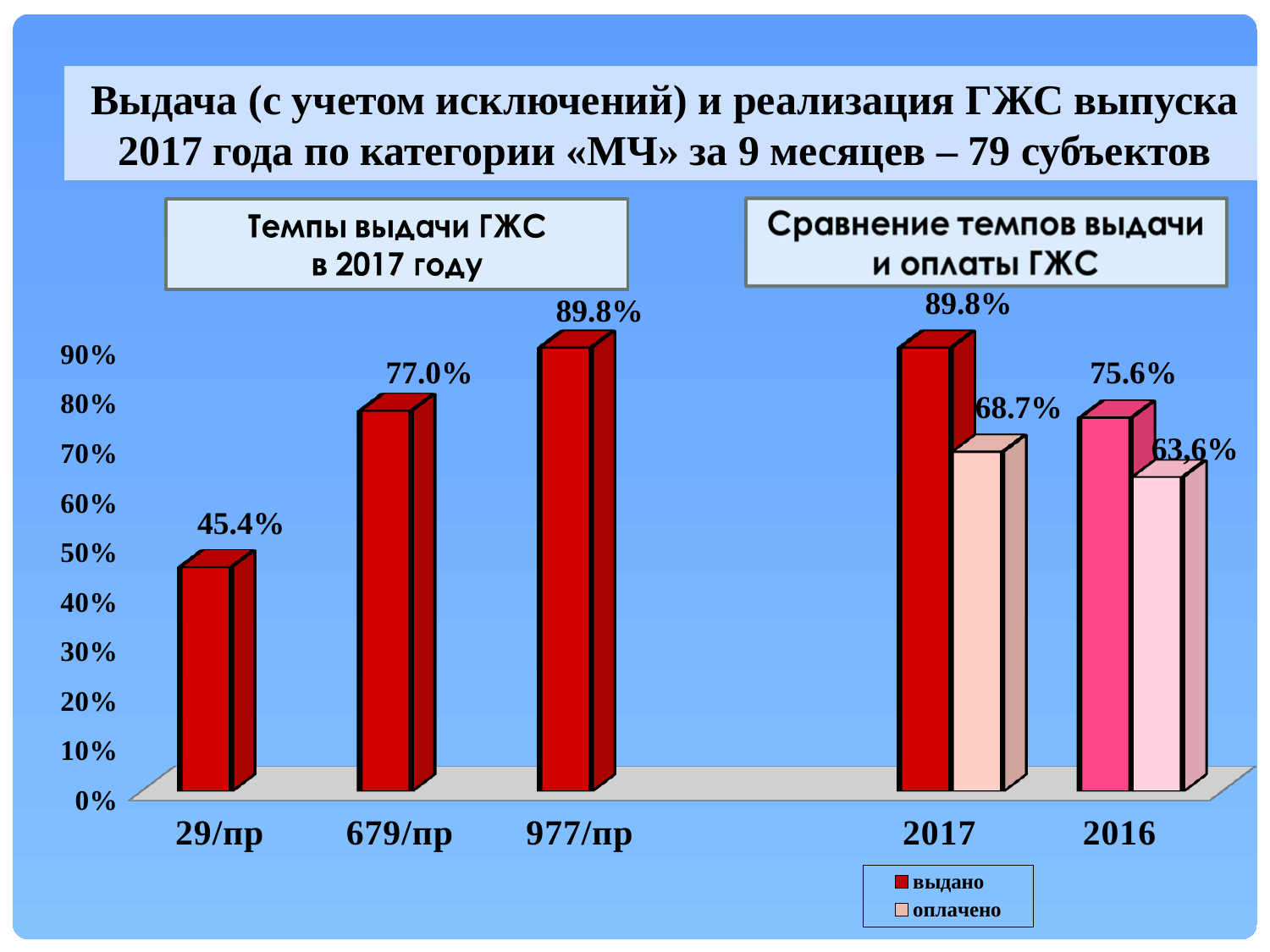
In the chart 'Сравнение темпов выдачи и оплаты ГЖС', how many series does the legend list? 2 In the chart 'Темпы выдачи ГЖС в 2017 году', which category has the highest value? 977/пр In the chart 'Темпы выдачи ГЖС в 2017 году', what is the value for 679/пр? 77.0% In the chart 'Темпы выдачи ГЖС в 2017 году', do the values rise or fall from left to right? rise In the chart 'Сравнение темпов выдачи и оплаты ГЖС', what is the 'выдано' value for 2016? 75.6% In the chart 'Темпы выдачи ГЖС в 2017 году', what is the value for 29/пр? 45.4% In the chart 'Сравнение темпов выдачи и оплаты ГЖС', what is the 'оплачено' value for 2017? 68.7% In the chart 'Темпы выдачи ГЖС в 2017 году', which category has the lowest value? 29/пр In the chart 'Темпы выдачи ГЖС в 2017 году', how many categories are shown? 3 In the chart 'Темпы выдачи ГЖС в 2017 году', what is the difference between the values for 977/пр and 29/пр? 44.4% In the chart 'Сравнение темпов выдачи и оплаты ГЖС', what is the difference between 'выдано' and 'оплачено' for 2016? 12.0% What kind of chart is 'Сравнение темпов выдачи и оплаты ГЖС'? bar chart